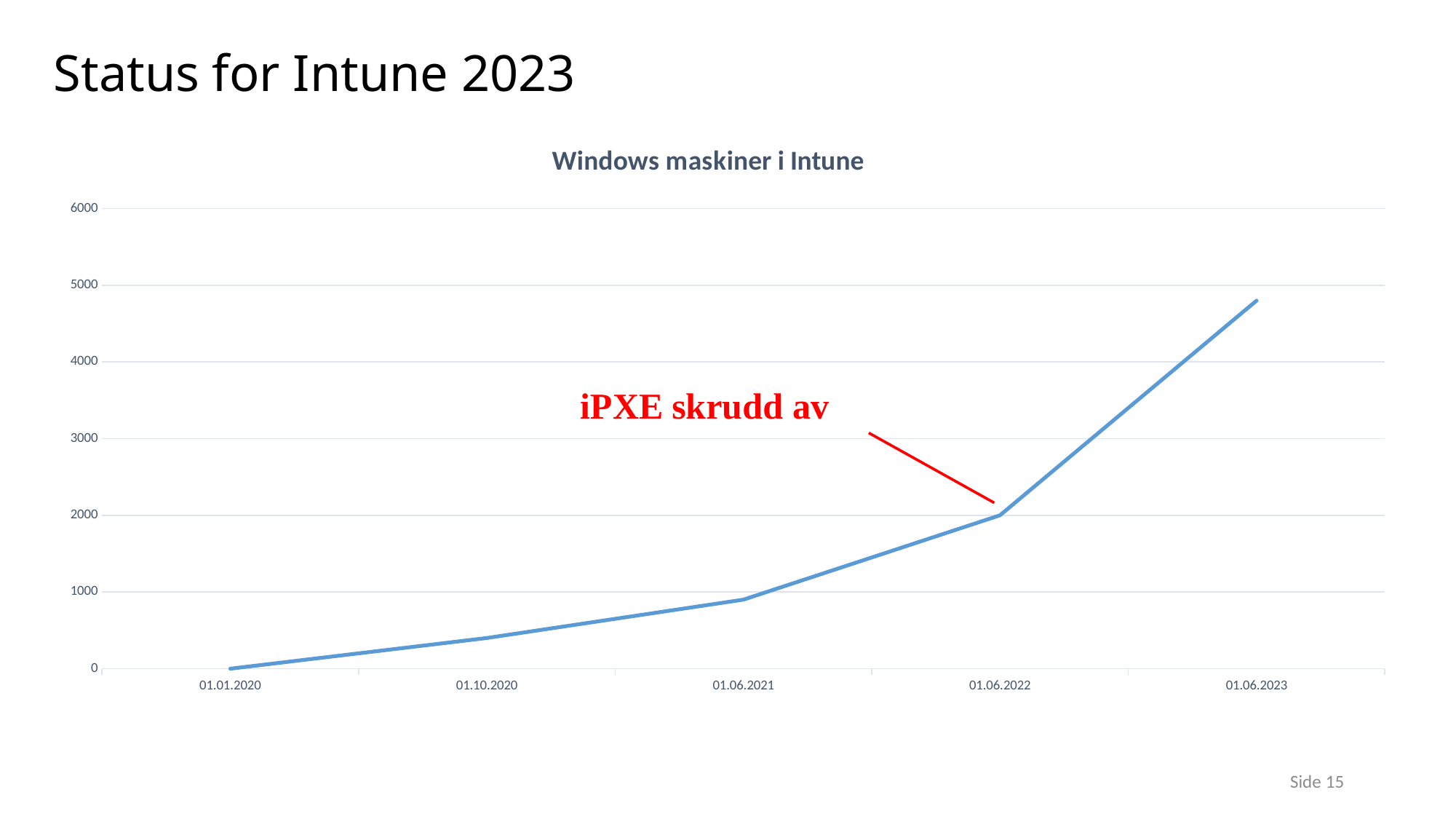
Which date has the lowest value? 01.01.2020 Is the value for 01.06.2023 greater or less than 5000? less Which date has the highest value? 01.06.2023 Do the values rise or fall from 01.01.2020 to 01.06.2023? rise What type of chart is shown on the slide? line chart Is the value for 01.06.2022 greater or less than 3000? less Which is larger, the value for 01.06.2022 or the value for 01.06.2023? 01.06.2023 What is the title of the chart? Windows maskiner i Intune Which data point does the red annotation "iPXE skrudd av" point to? 01.06.2022 How many data points are plotted on the line? 5 Is the value for 01.06.2023 greater or less than 4000? greater